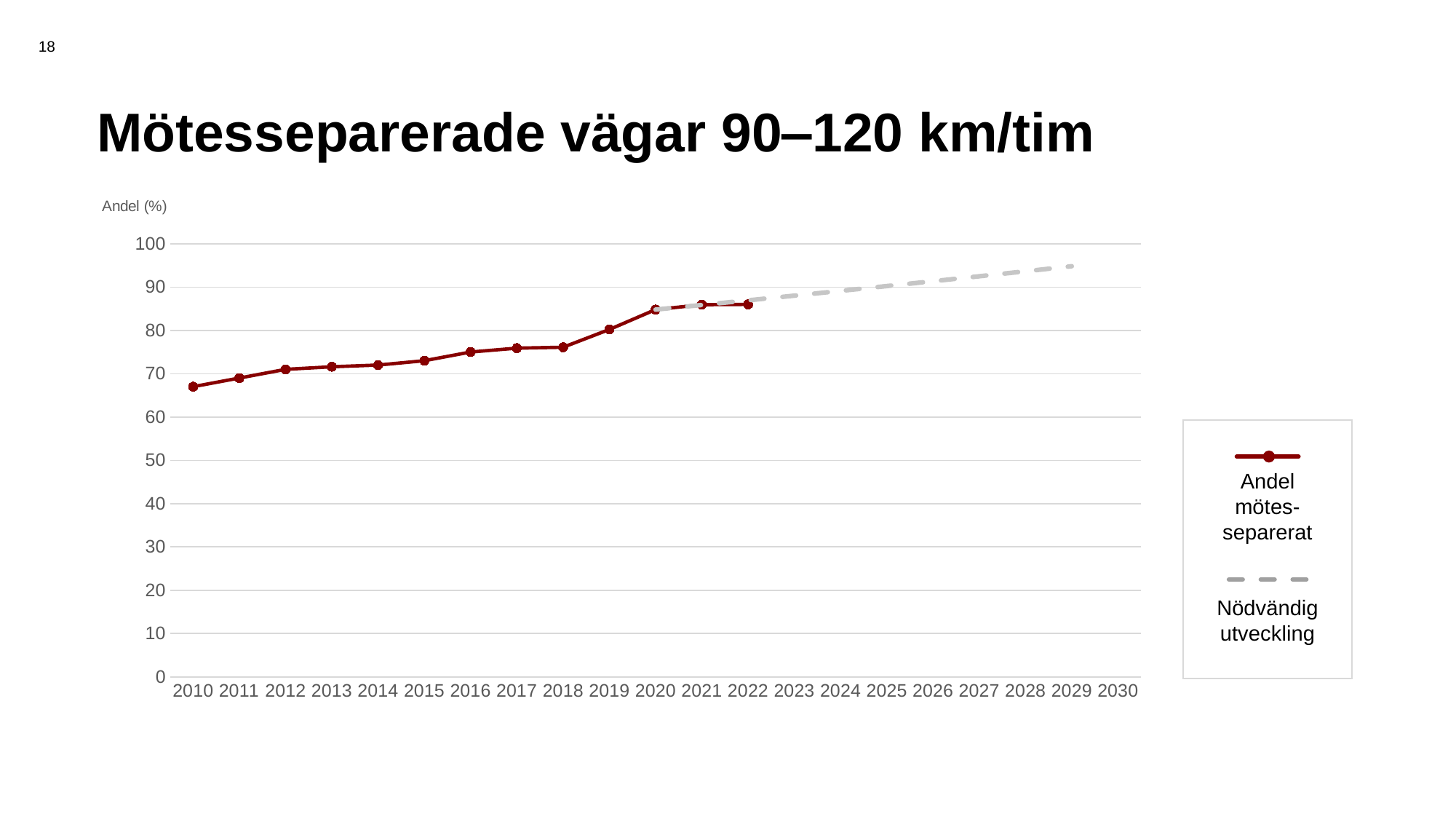
How many data points does the Andel mötesseparerat line have? 13 How many series does the legend list? 2 Which is larger, the value for Andel mötesseparerat in 2015 or in 2020? 2020 Which year has the lowest value for Andel mötesseparerat? 2010 Is the value for Andel mötesseparerat in 2022 greater or less than 90? less Do the values for Andel mötesseparerat rise or fall from 2010 to 2022? rise Is the value for Andel mötesseparerat in 2020 greater or less than 80? greater Is the value for Andel mötesseparerat in 2016 greater or less than 70? greater What is the label on the vertical axis of the chart? Andel (%) What kind of chart is shown on the slide? line chart